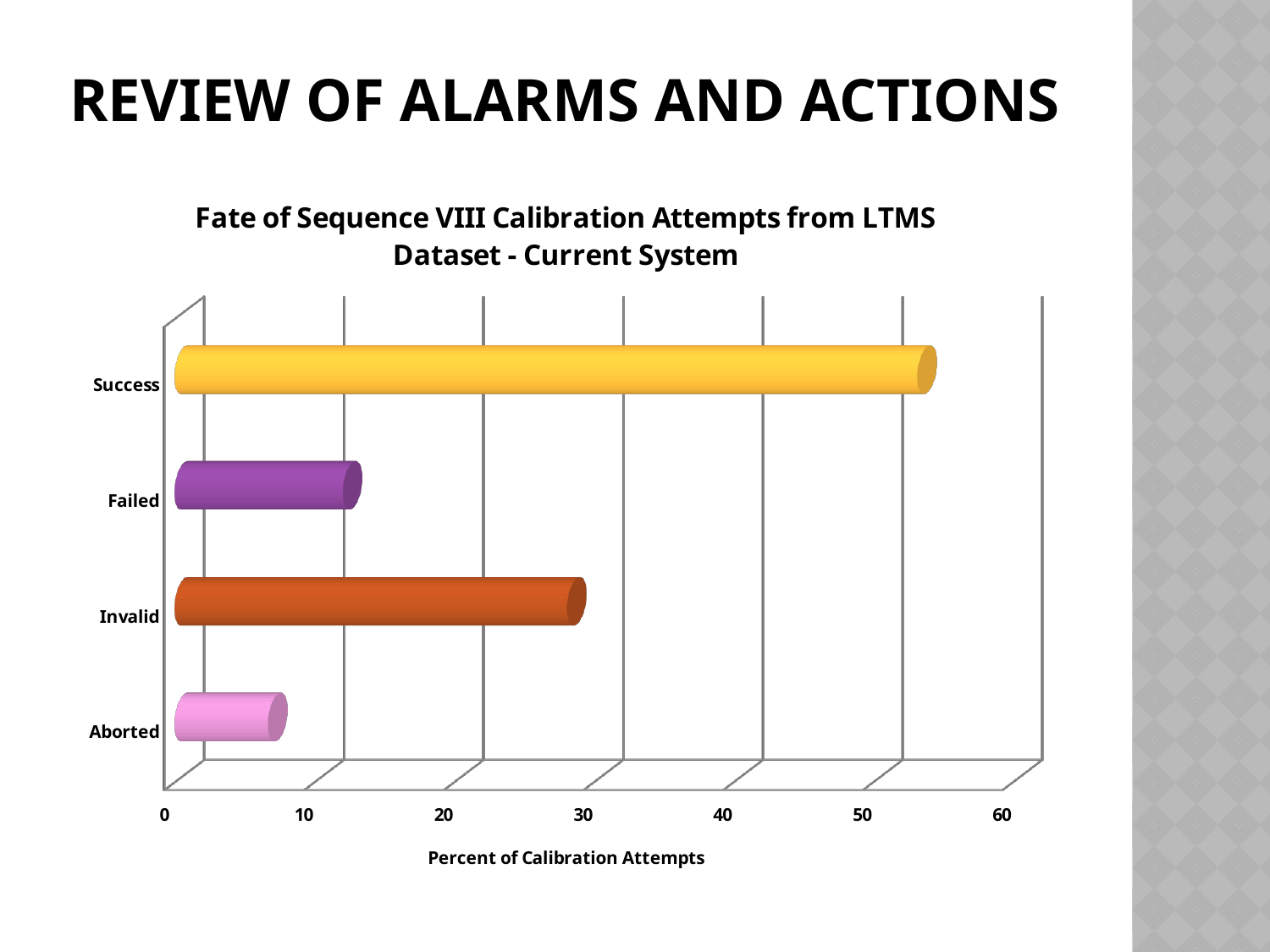
How many categories are plotted in the chart? 4 Is the value for Aborted greater or less than 10? less What is the title of the chart? Fate of Sequence VIII Calibration Attempts from LTMS Dataset - Current System Which is larger, the value for Invalid or the value for Failed? Invalid Is the value for Success greater or less than 50? greater What kind of chart is shown on the slide? Bar chart Is the value for Invalid greater or less than 20? greater Which category has the lowest percent of calibration attempts? Aborted What is the label of the horizontal axis? Percent of Calibration Attempts Which is larger, the value for Failed or the value for Aborted? Failed Which category has the highest percent of calibration attempts? Success